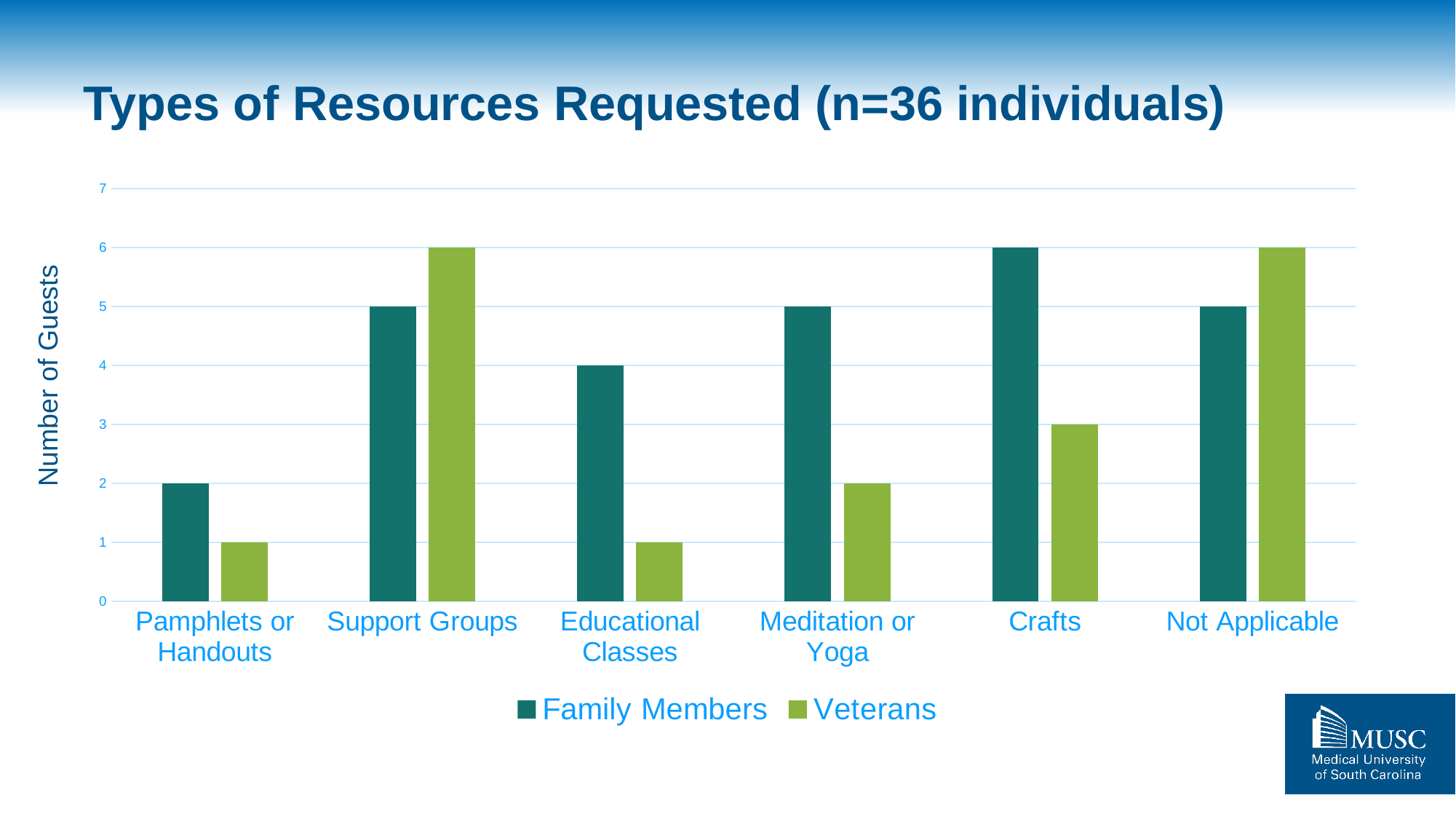
Which category has the highest value for Family Members? Crafts How many resource categories are shown on the x axis? 6 What is the title of the chart? Types of Resources Requested (n=36 individuals) What is the number of guests for Veterans in the Meditation or Yoga category? 2 In the Not Applicable category, which is larger, Family Members or Veterans? Veterans Which category has the lowest value for Family Members? Pamphlets or Handouts What type of chart is shown on the slide? Bar chart What is the number of guests for Family Members in the Crafts category? 6 What is the difference between Family Members and Veterans in the Crafts category? 3 What is the number of guests for Veterans in the Support Groups category? 6 How many series does the legend list? 2 What is the number of guests for Family Members in the Educational Classes category? 4